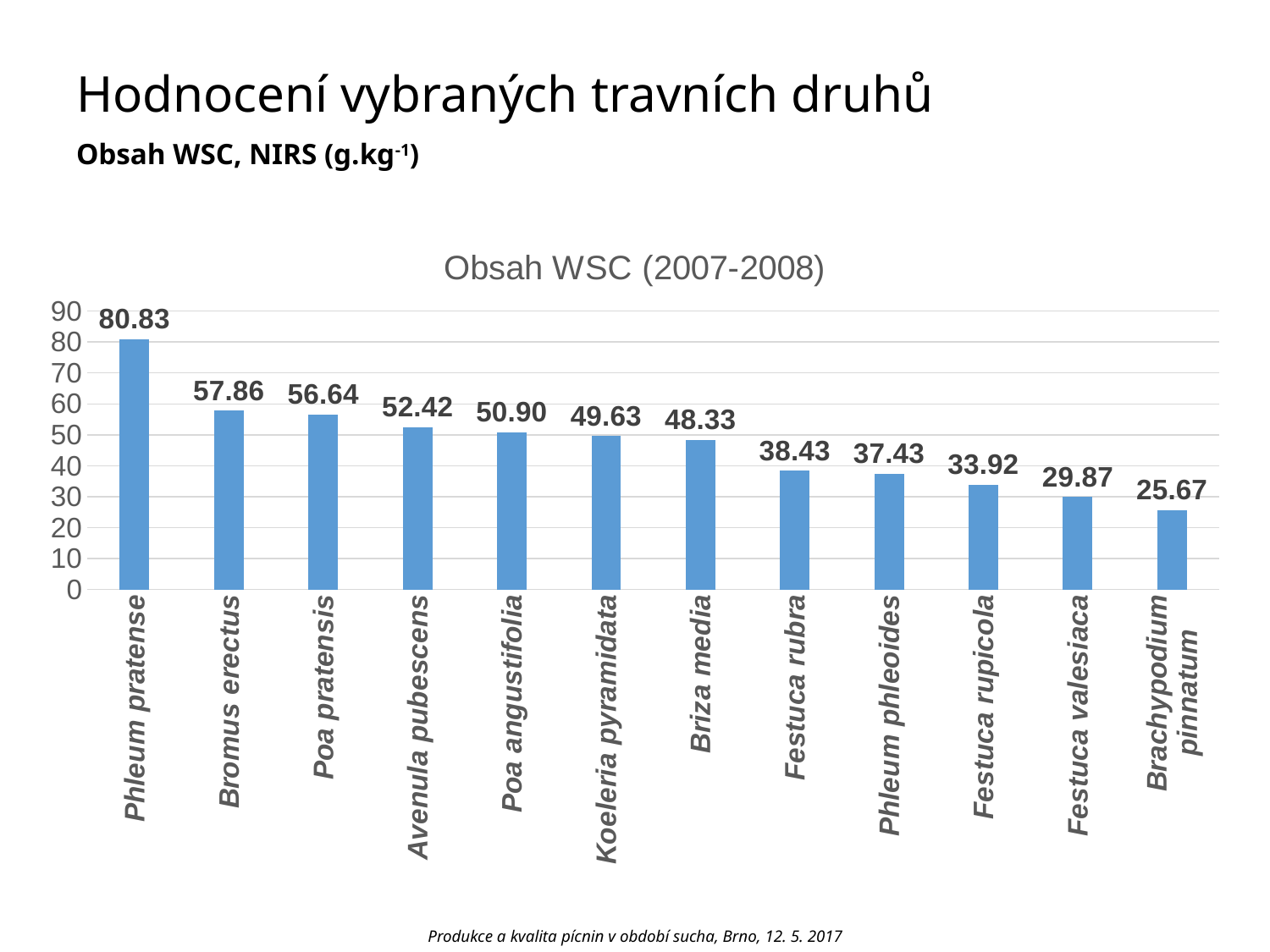
What is the title of the chart? Obsah WSC (2007-2008) What is the value for Brachypodium pinnatum? 25.67 What is the value for Phleum pratense? 80.83 What is the difference between the values for Phleum pratense and Brachypodium pinnatum? 55.16 How many categories are shown in the chart? 12 What kind of chart is shown on the slide? Bar chart What is the difference between the values for Bromus erectus and Poa pratensis? 1.22 What is the value for Festuca rubra? 38.43 Do the values rise or fall from left to right along the x axis? Fall Which category has the lowest value? Brachypodium pinnatum Which category has the highest value? Phleum pratense Which is larger, the value for Briza media or the value for Phleum phleoides? Briza media